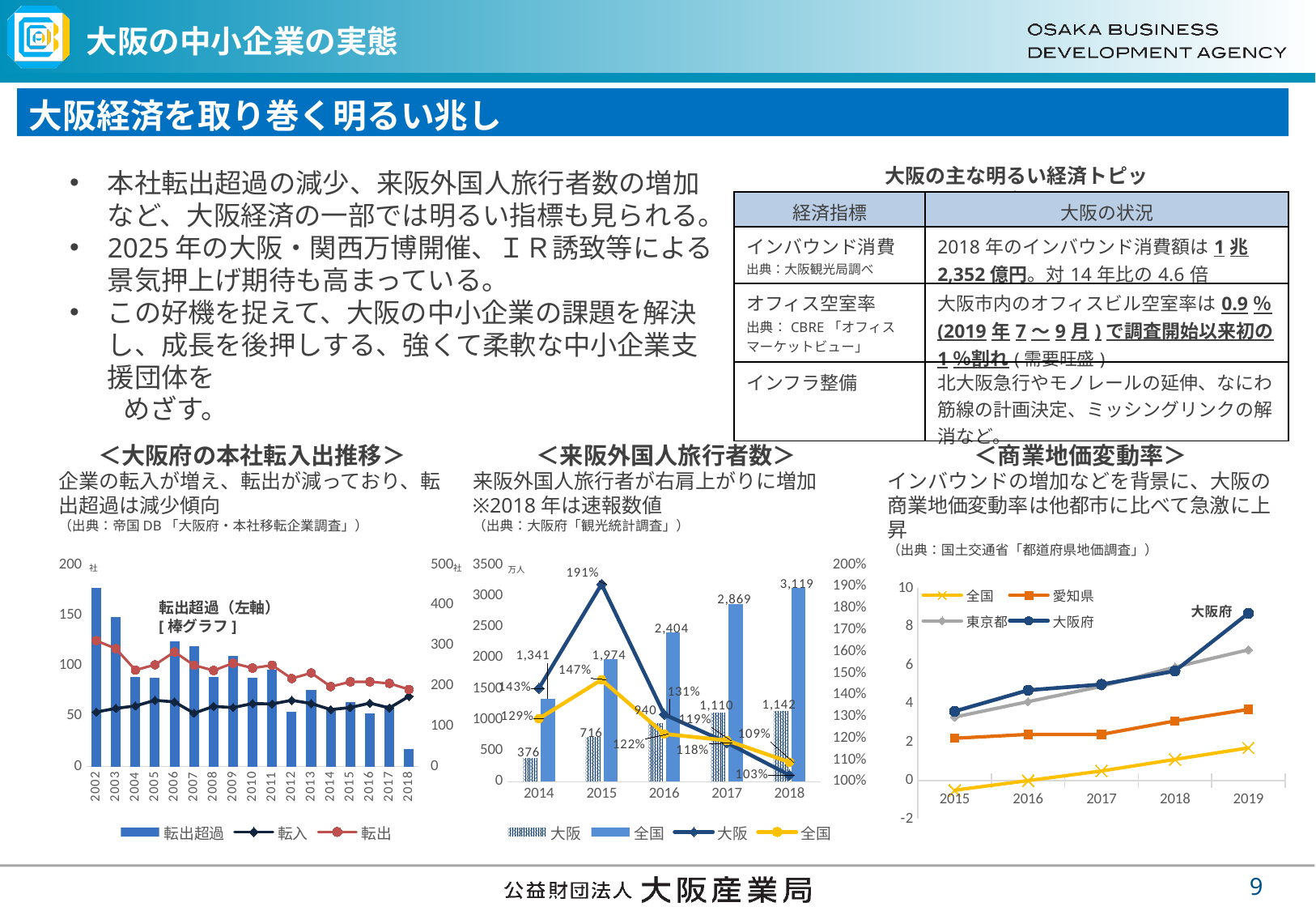
In the ＜商業地価変動率＞ chart, which series has the highest value in 2019? 大阪府 In the ＜来阪外国人旅行者数＞ chart, in which year does the 大阪 line reach its highest percentage? 2015 What kind of chart is the ＜商業地価変動率＞ chart? Line chart How many series does the legend of the ＜大阪府の本社転入出推移＞ chart list? 3 In the ＜来阪外国人旅行者数＞ chart, what is the difference between the 全国 bar and the 大阪 bar in 2018? 1,977 In the ＜商業地価変動率＞ chart, is the value for 全国 in 2015 greater or less than 0? less How many series does the legend of the ＜来阪外国人旅行者数＞ chart list? 4 In the ＜来阪外国人旅行者数＞ chart, what is the value of the 全国 bar for 2018? 3,119 How many years are shown on the x axis of the ＜来阪外国人旅行者数＞ chart? 5 How many years are shown on the x axis of the ＜大阪府の本社転入出推移＞ chart? 17 In the ＜来阪外国人旅行者数＞ chart, what percentage does the 全国 line show for 2015? 147% In the ＜来阪外国人旅行者数＞ chart, what is the value of the 大阪 bar for 2014? 376